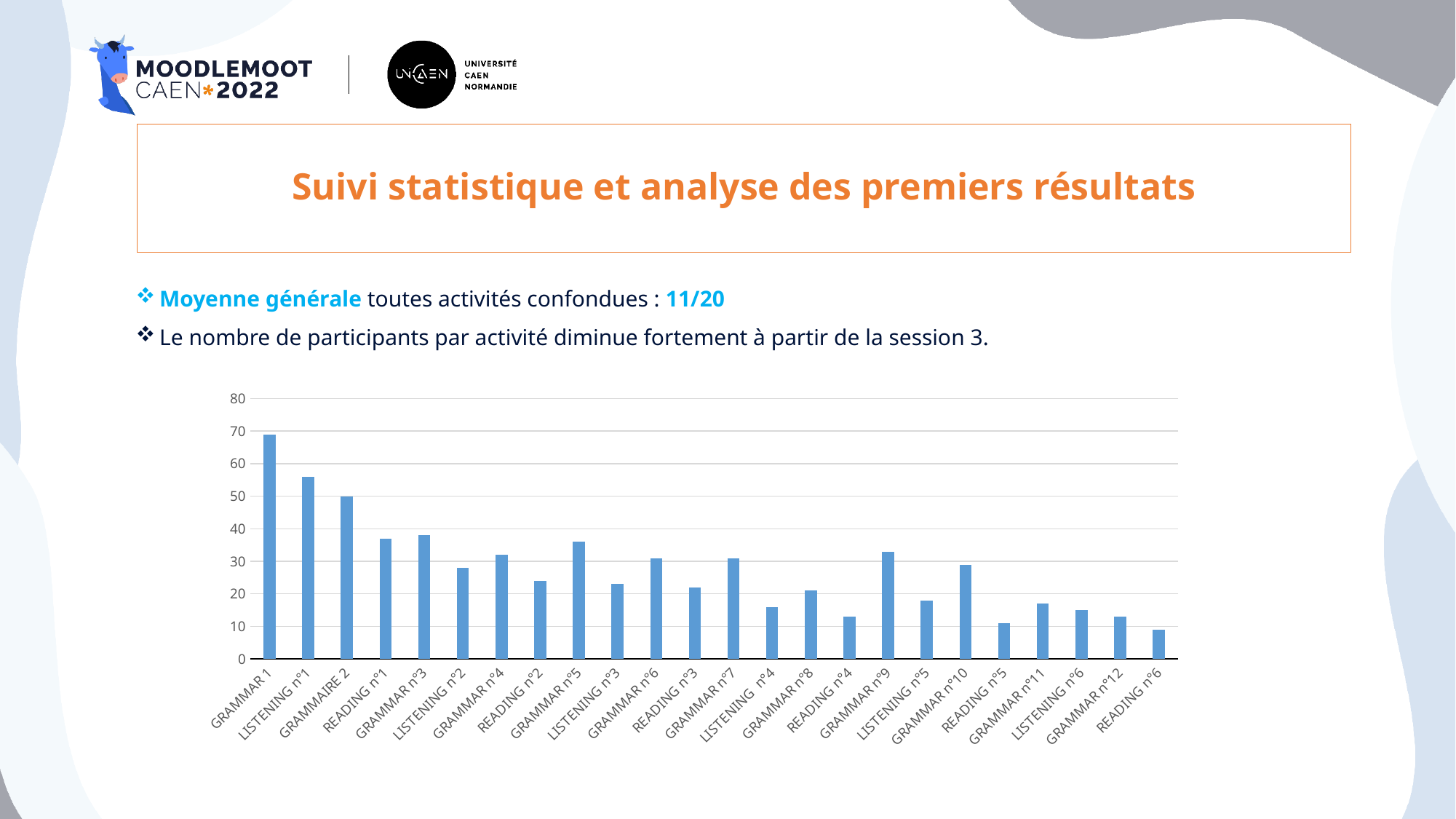
Overall, do the values rise or fall from left to right along the x axis? Fall Is the value for LISTENING n°4 greater or less than 20? less What kind of chart is shown on the slide? Bar chart Is the value for GRAMMAR 1 greater or less than 60? greater Is the value for LISTENING n°1 greater or less than 50? greater What colour are the bars in the chart? Blue How many activities (categories) are plotted on the chart? 24 Which is larger, the value for GRAMMAR 1 or the value for LISTENING n°1? GRAMMAR 1 Which activity has the highest number of participants? GRAMMAR 1 Which is larger, the value for GRAMMAR n°9 or the value for READING n°4? GRAMMAR n°9